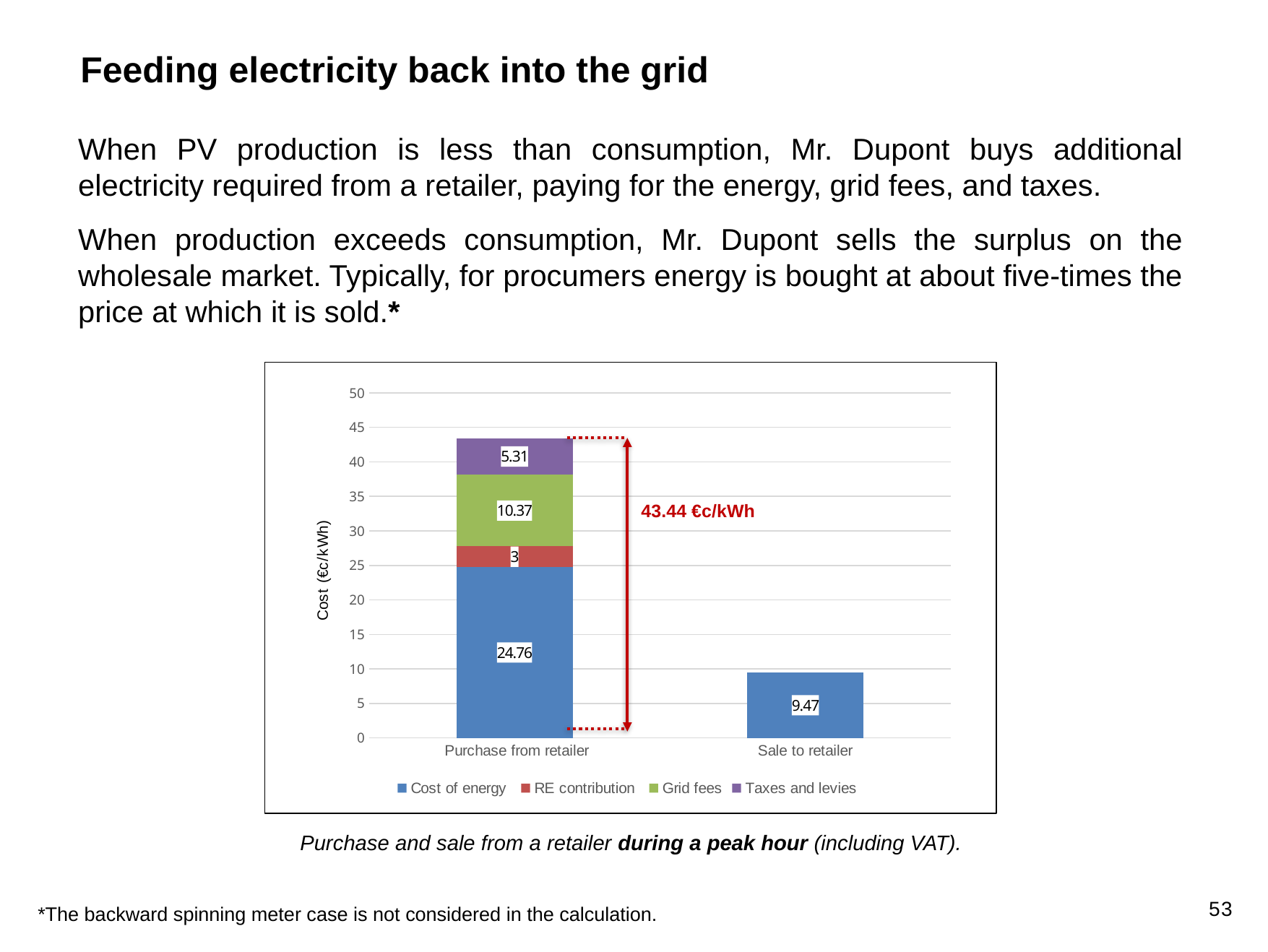
What is the value of the Cost of energy segment for Purchase from retailer? 24.76 What type of chart is shown on the slide? Stacked bar chart How many categories are shown on the x axis? 2 Which category has the higher total bar, Purchase from retailer or Sale to retailer? Purchase from retailer How many series does the legend list? 4 What is the difference between the Cost of energy for Purchase from retailer and for Sale to retailer? 15.29 What is the value of the Taxes and levies segment for Purchase from retailer? 5.31 Which segment of the Purchase from retailer bar is the smallest? RE contribution What is the total of the stacked bar for Purchase from retailer? 43.44 What is the value of the Grid fees segment for Purchase from retailer? 10.37 What is the value of the Cost of energy segment for Sale to retailer? 9.47 What is the value of the RE contribution segment for Purchase from retailer? 3